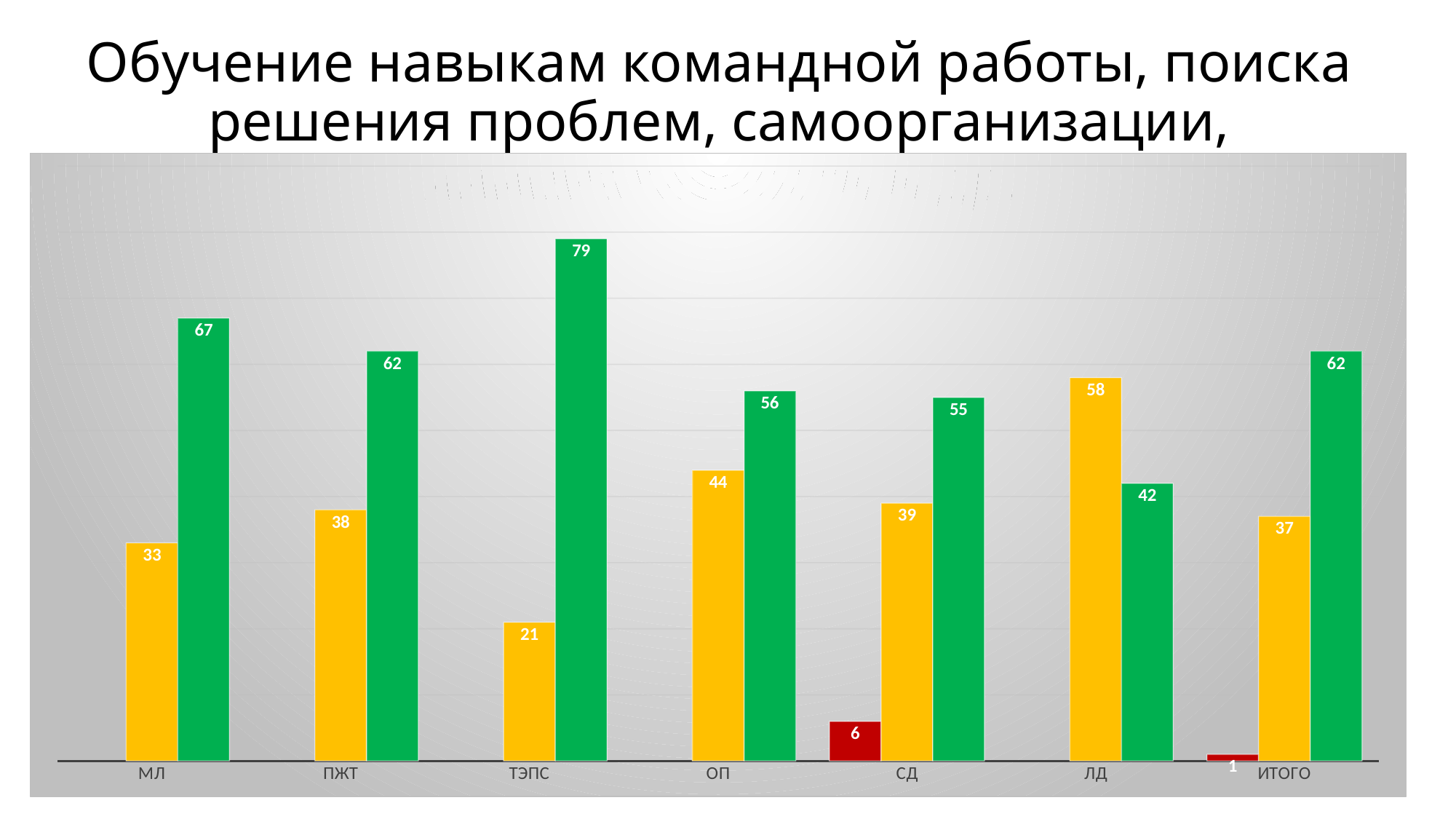
What is the value of the yellow bar for ИТОГО? 37 How many categories are shown along the x axis of the chart? 7 What is the value of the red bar for СД? 6 What is the value of the green bar for ТЭПС? 79 What is the value of the yellow bar for ЛД? 58 What is the difference between the green bar and the yellow bar for МЛ? 34 Which is larger for ЛД, the yellow bar or the green bar? the yellow bar Which category has the highest green bar? ТЭПС What kind of chart is shown on the slide? bar chart Which category has the lowest yellow bar? ТЭПС Which categories have a red bar? СД and ИТОГО What is the difference between the green bars for ТЭПС and ОП? 23